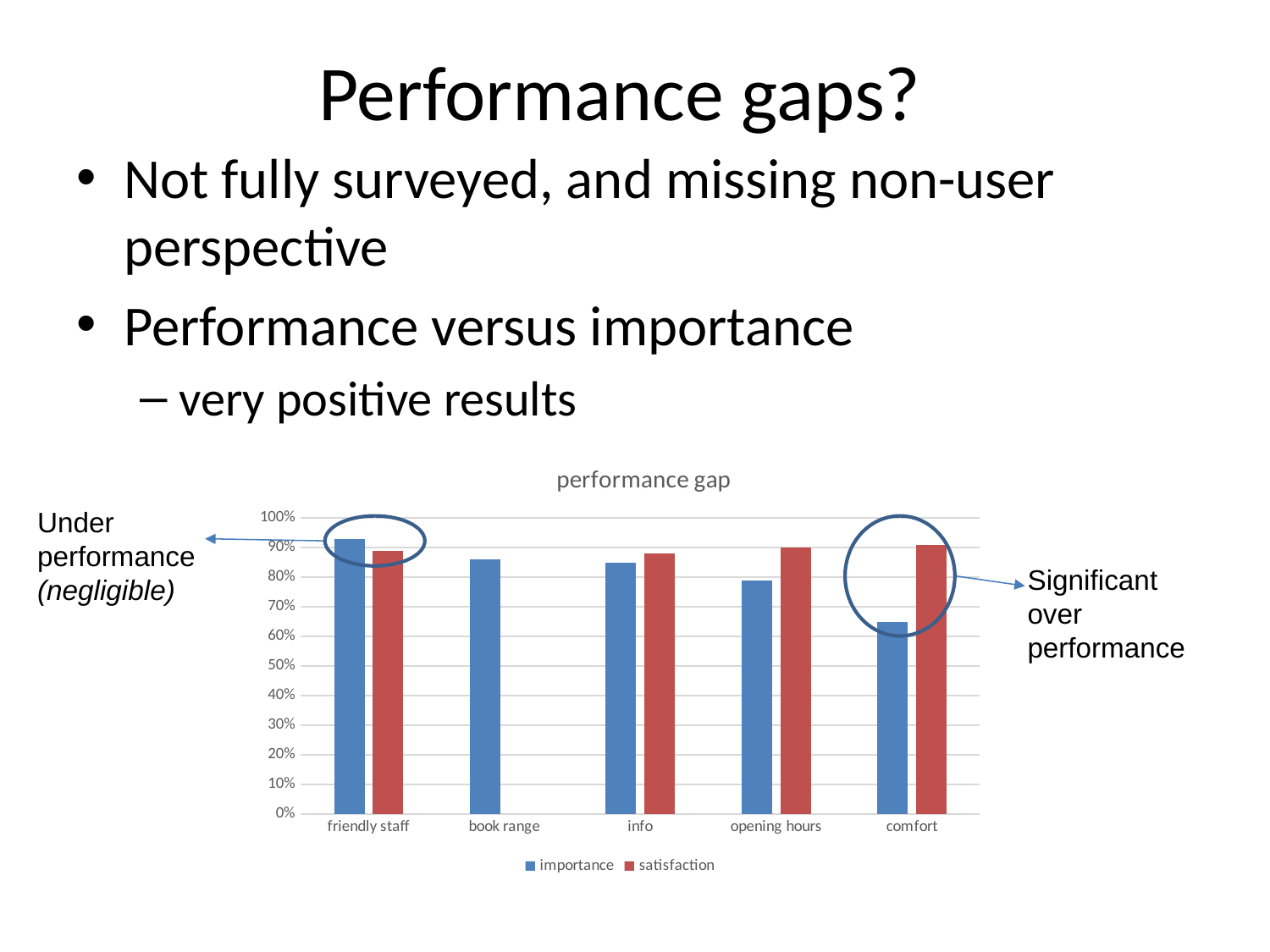
Is the importance value for book range greater or less than 80%? greater How many series does the chart legend list? 2 Which category has the highest importance value? friendly staff Is the importance value for friendly staff greater or less than 90%? greater How many categories are shown on the x axis of the chart? 5 Which category has no satisfaction bar plotted? book range For comfort, which is larger: importance or satisfaction? satisfaction What is the title of the chart? performance gap What kind of chart is shown on the slide? bar chart For opening hours, which is larger: importance or satisfaction? satisfaction Is the importance value for comfort greater or less than 70%? less Which category has the lowest importance value? comfort